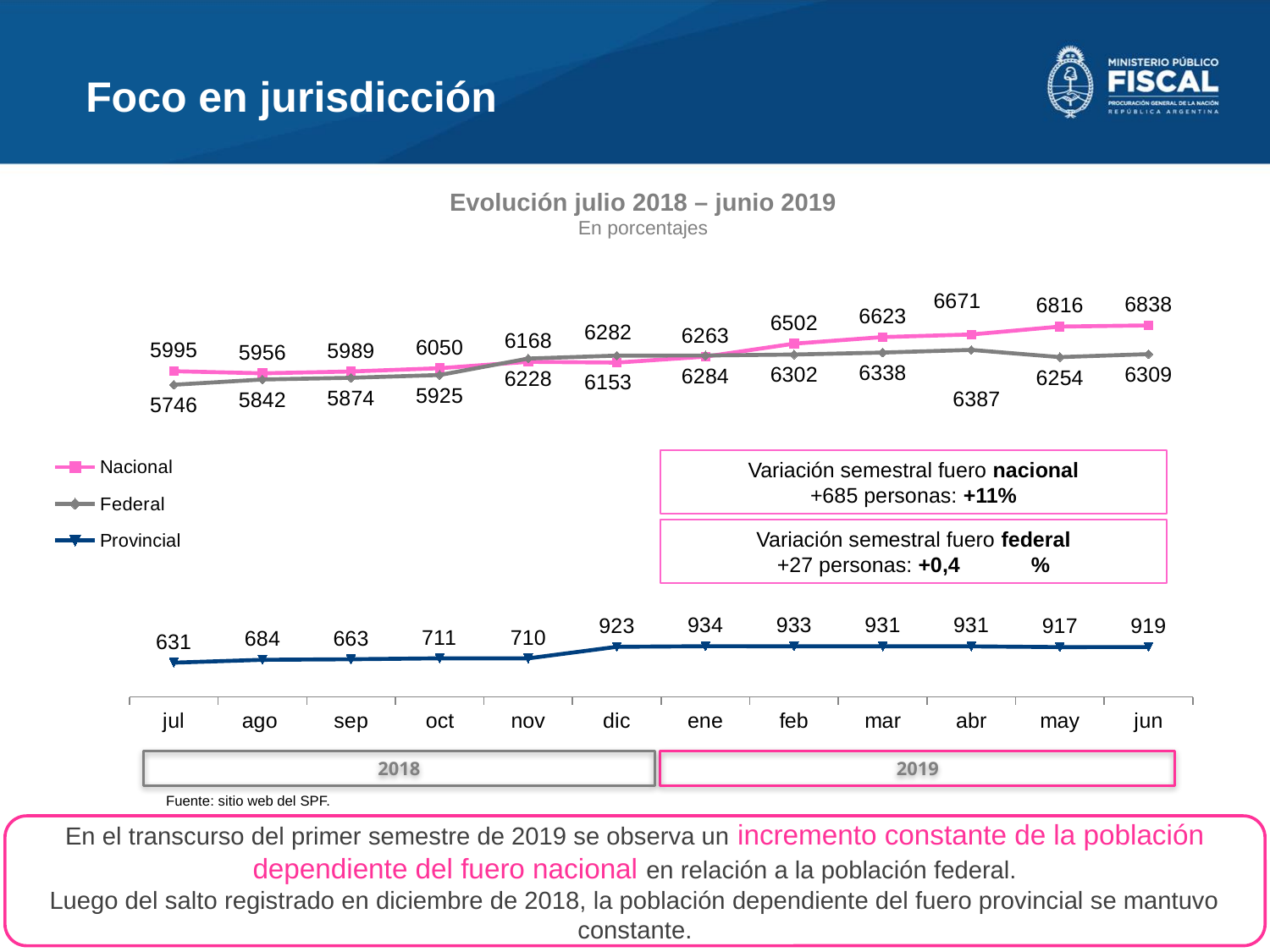
What kind of chart is shown on the slide? Line chart What is the value for the Federal series in jul? 5746 What is the difference between the Provincial value in dic and the Provincial value in nov? 213 What is the value for the Provincial series in dic? 923 How many series does the legend list? 3 In which month does the Provincial series reach its highest value? ene In which month does the Provincial series have its lowest value? jul What is the value for the Nacional series in jun? 6838 How many months are shown on the x axis of the chart? 12 In mar, which series has the larger value, Nacional or Federal? Nacional What is the difference between the Nacional value in jun and the Nacional value in jul? 843 Does the Nacional series rise or fall from feb to jun? Rise